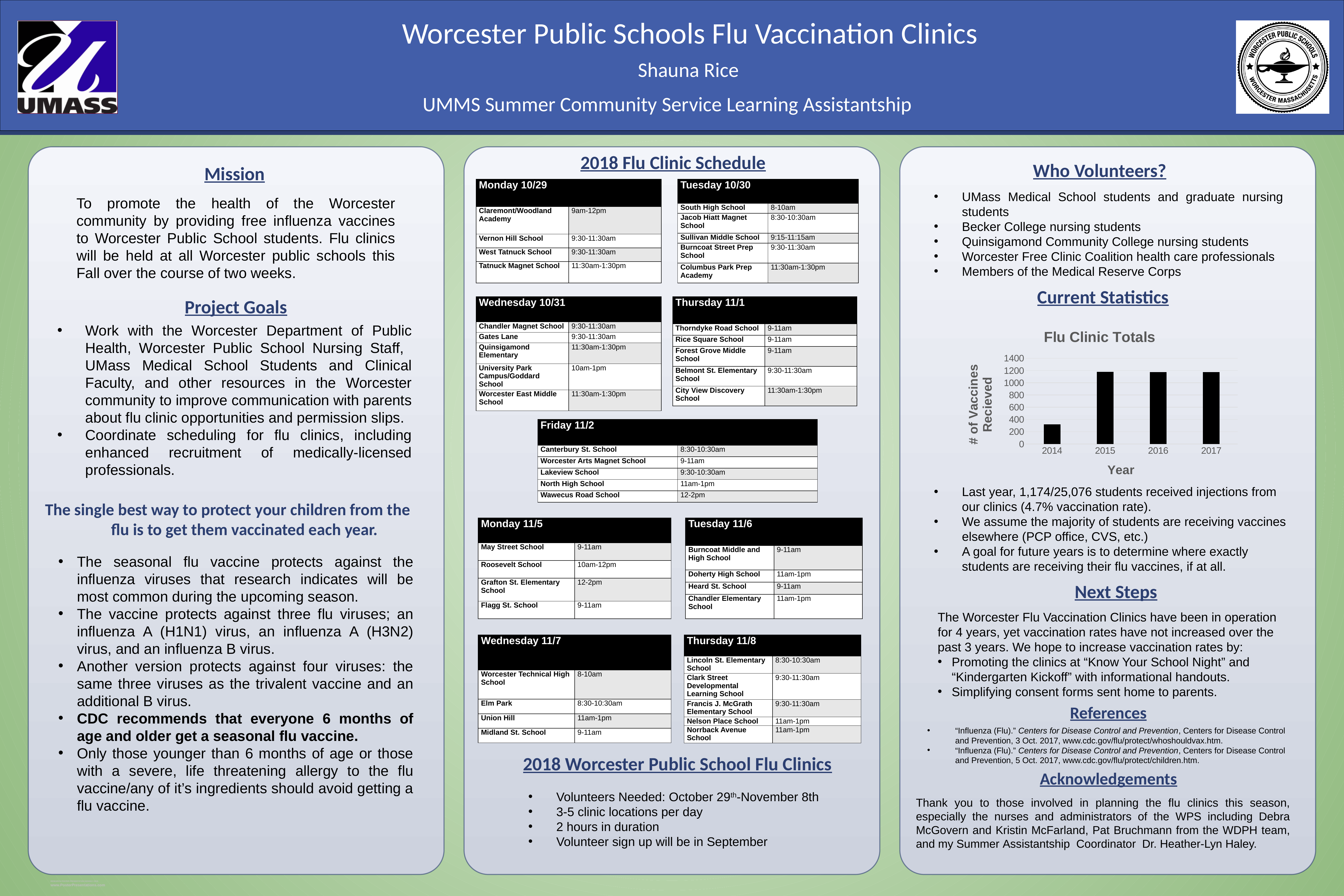
What is the label on the x axis of the Flu Clinic Totals chart? Year Which year has the lowest value in the Flu Clinic Totals chart? 2014 What type of chart is the Flu Clinic Totals chart? bar chart What is the highest tick value shown on the y axis of the Flu Clinic Totals chart? 1400 In the Flu Clinic Totals chart, is the value for 2014 greater or less than 400? less What is the title of the chart in the Current Statistics section? Flu Clinic Totals In the Flu Clinic Totals chart, which year has the larger value, 2014 or 2016? 2016 In the Flu Clinic Totals chart, is the value for 2014 greater or less than 200? greater In the Flu Clinic Totals chart, is the value for 2015 greater or less than 1000? greater How many years are shown on the x axis of the Flu Clinic Totals chart? 4 In the Flu Clinic Totals chart, do the values rise or fall from 2014 to 2015? rise